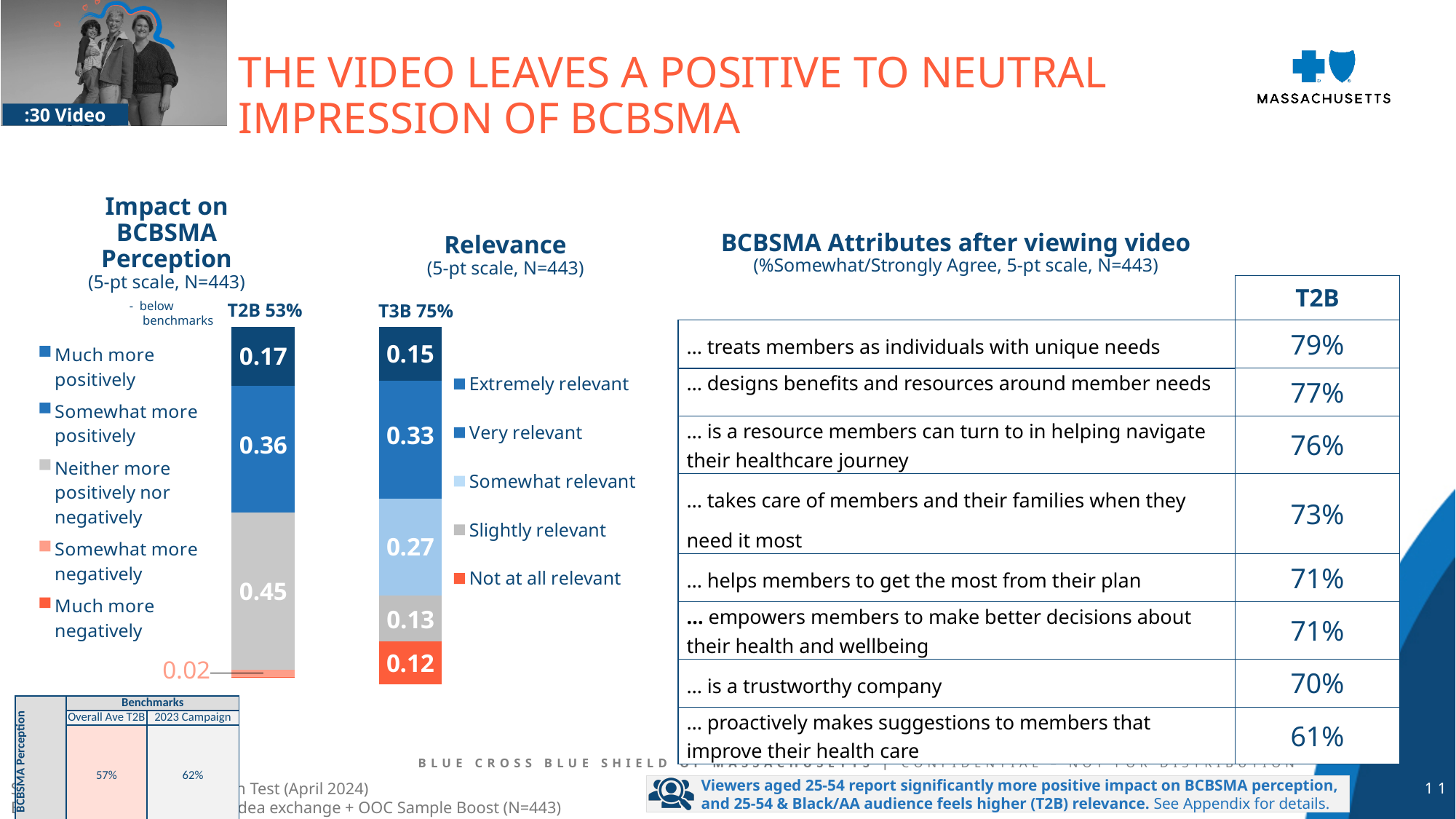
In the Relevance chart, what is the value for "Very relevant"? 0.33 In the Relevance chart, what is the difference between "Very relevant" and "Extremely relevant"? 0.18 In the Impact on BCBSMA Perception chart, what T2B percentage is shown above the bar? 53% In the Impact on BCBSMA Perception chart, what is the value for "Much more positively"? 0.17 In the Impact on BCBSMA Perception chart, what is the value for "Somewhat more positively"? 0.36 In the Relevance chart, what T3B percentage is shown above the bar? 75% In the Relevance chart, what is the value for "Not at all relevant"? 0.12 In the Relevance chart, what is the value for "Somewhat relevant"? 0.27 In the Impact on BCBSMA Perception chart, which segment has the largest value? Neither more positively nor negatively How many entries does the legend of the Impact on BCBSMA Perception chart list? 5 What kind of chart is the Relevance chart? Stacked bar chart In the Impact on BCBSMA Perception chart, which is larger: "Much more positively" or "Somewhat more positively"? Somewhat more positively